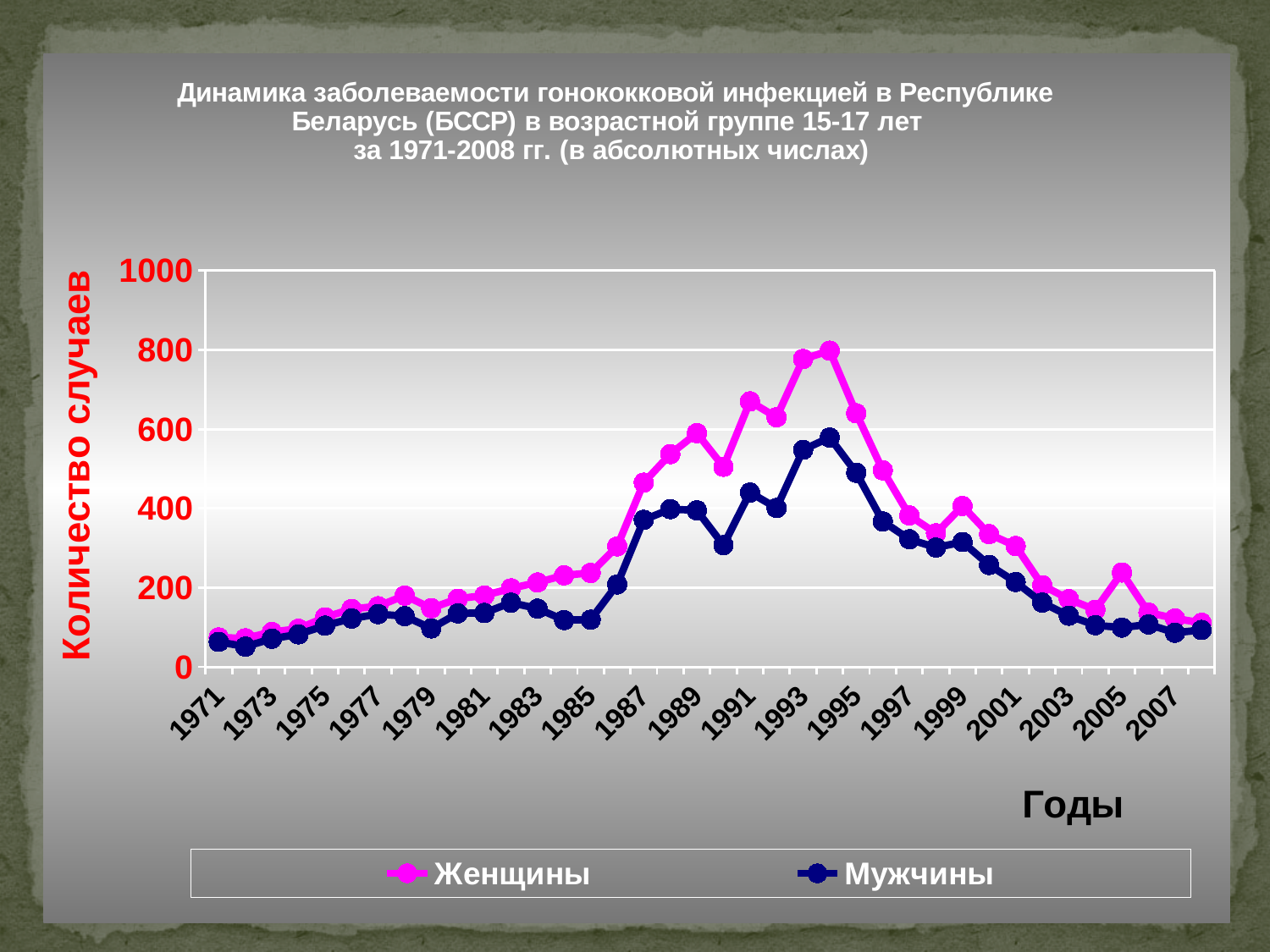
Is the value for Женщины in 1971 greater or less than 200? less What is the label of the vertical axis? Количество случаев Which series has the larger value in 1989, Женщины or Мужчины? Женщины Do the values for Женщины rise or fall from 1994 to 2008? fall What kind of chart is shown on the slide? line chart How many series does the legend list? 2 In which year does the Женщины series reach its highest value? 1994 Is the value for Мужчины in 1989 greater or less than 600? less Is the value for Мужчины in 1994 greater or less than 400? greater What are the two series named in the legend? Женщины and Мужчины